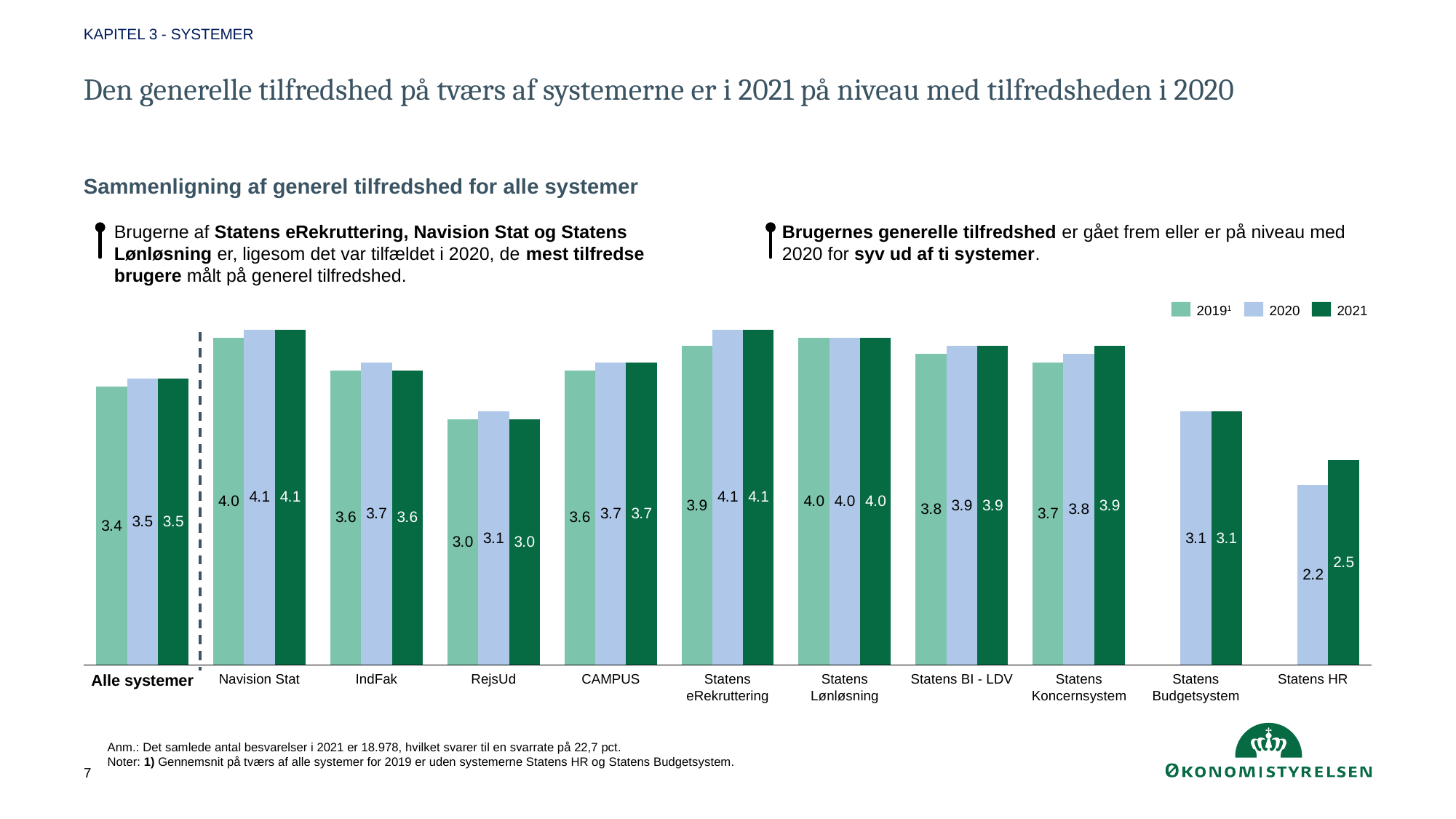
How many categories are shown on the x axis? 11 Which is larger in 2021: Statens Koncernsystem or IndFak? Statens Koncernsystem What is the value for Statens Koncernsystem in 2021? 3.9 What is the value for Navision Stat in 2019? 4.0 What is the value for Alle systemer in 2020? 3.5 What is the value for Statens HR in 2021? 2.5 How many series does the legend list? 3 Which system has the lowest value in 2020? Statens HR What kind of chart is shown? Bar chart Which system has the lowest value in 2021? Statens HR Do the values for Statens Koncernsystem rise or fall from 2019 to 2021? Rise What is the difference between the 2021 and 2020 values for Statens HR? 0.3